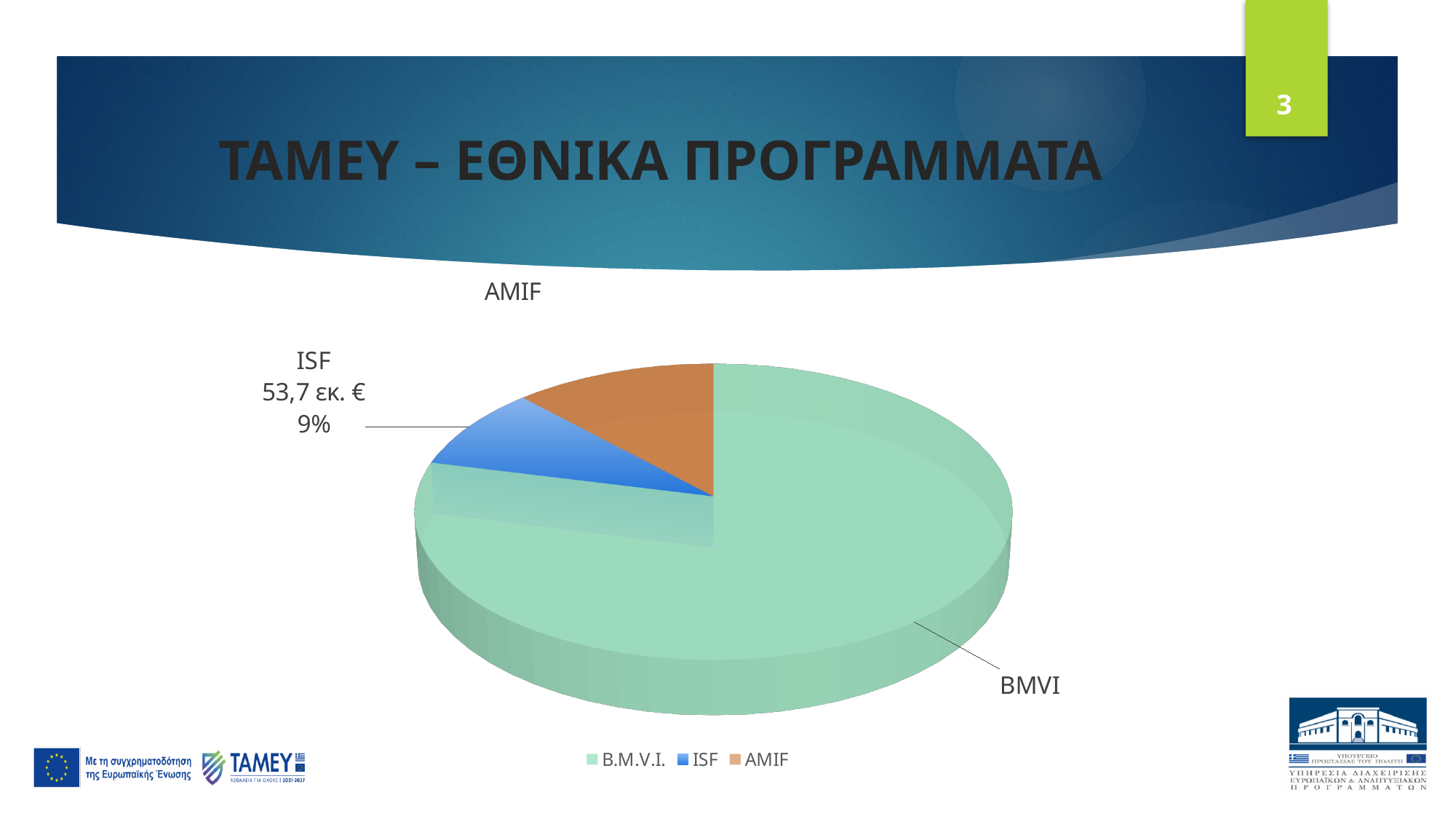
How many slices does the pie chart have? 3 What kind of chart is shown on the slide? pie chart Which slice of the pie chart is the largest? BMVI What share of the pie does the ISF slice represent? 9% How many entries does the legend of the pie chart list? 3 What amount is shown for the ISF slice of the pie chart? 53,7 εκ. € Which is larger in the pie chart, the BMVI slice or the ISF slice? BMVI Which is larger in the pie chart, the AMIF slice or the BMVI slice? BMVI What colour is the ISF slice in the pie chart? blue What is the title of the slide containing the pie chart? ΤΑΜΕΥ – ΕΘΝΙΚΑ ΠΡΟΓΡΑΜΜΑΤΑ